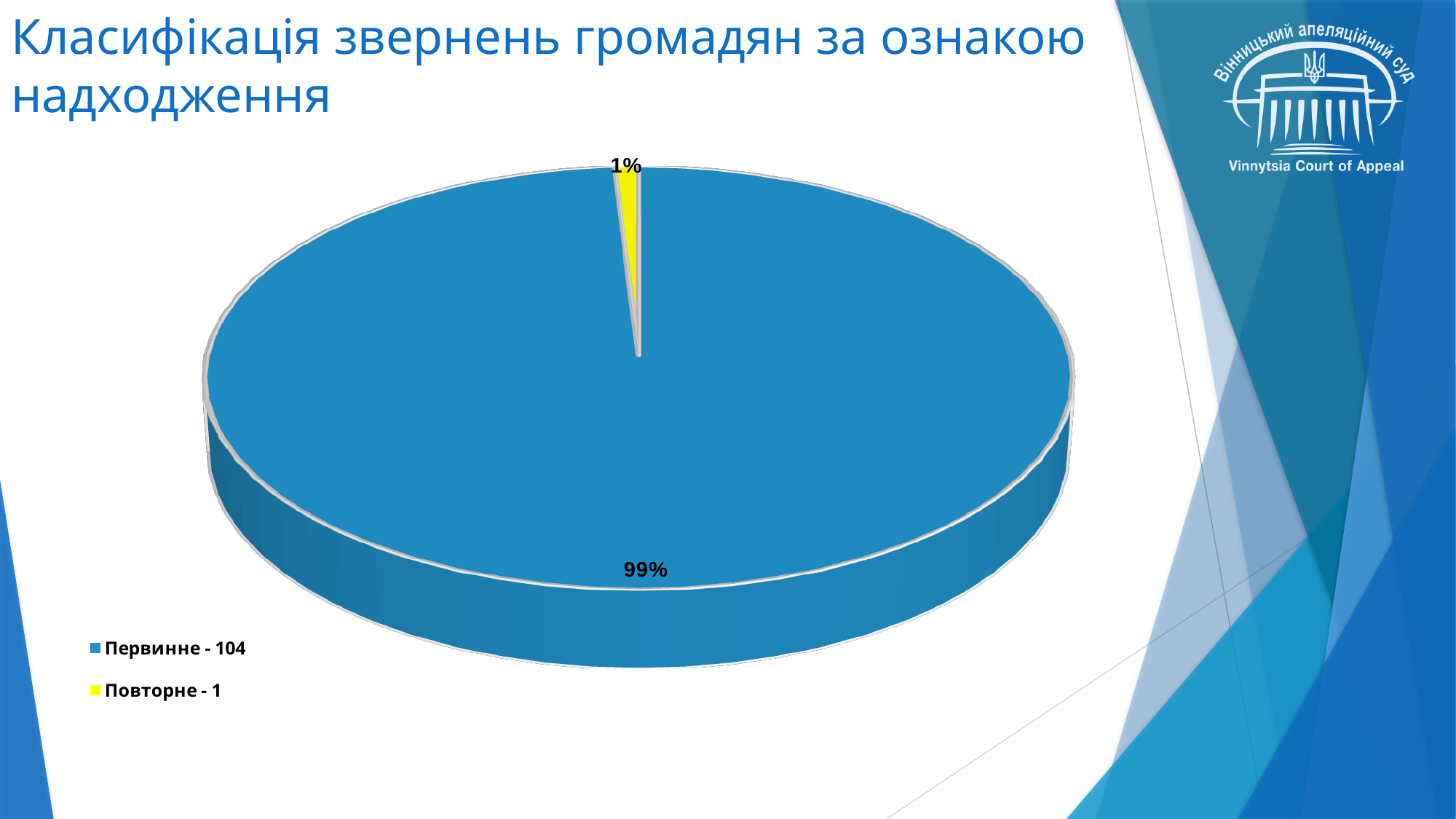
What is the difference between the values for Первинне and Повторне? 103 Which category has the largest slice of the pie? Первинне How many slices does the pie chart have? 2 How many entries does the legend list? 2 What value is shown for Первинне in the legend? 104 What share of the pie does the Повторне slice represent? 1% Which category has the smallest slice of the pie? Повторне What kind of chart is shown on the slide? pie chart Which is larger, Первинне or Повторне? Первинне What share of the pie does the Первинне slice represent? 99% What colour is the Повторне slice? yellow What value is shown for Повторне in the legend? 1